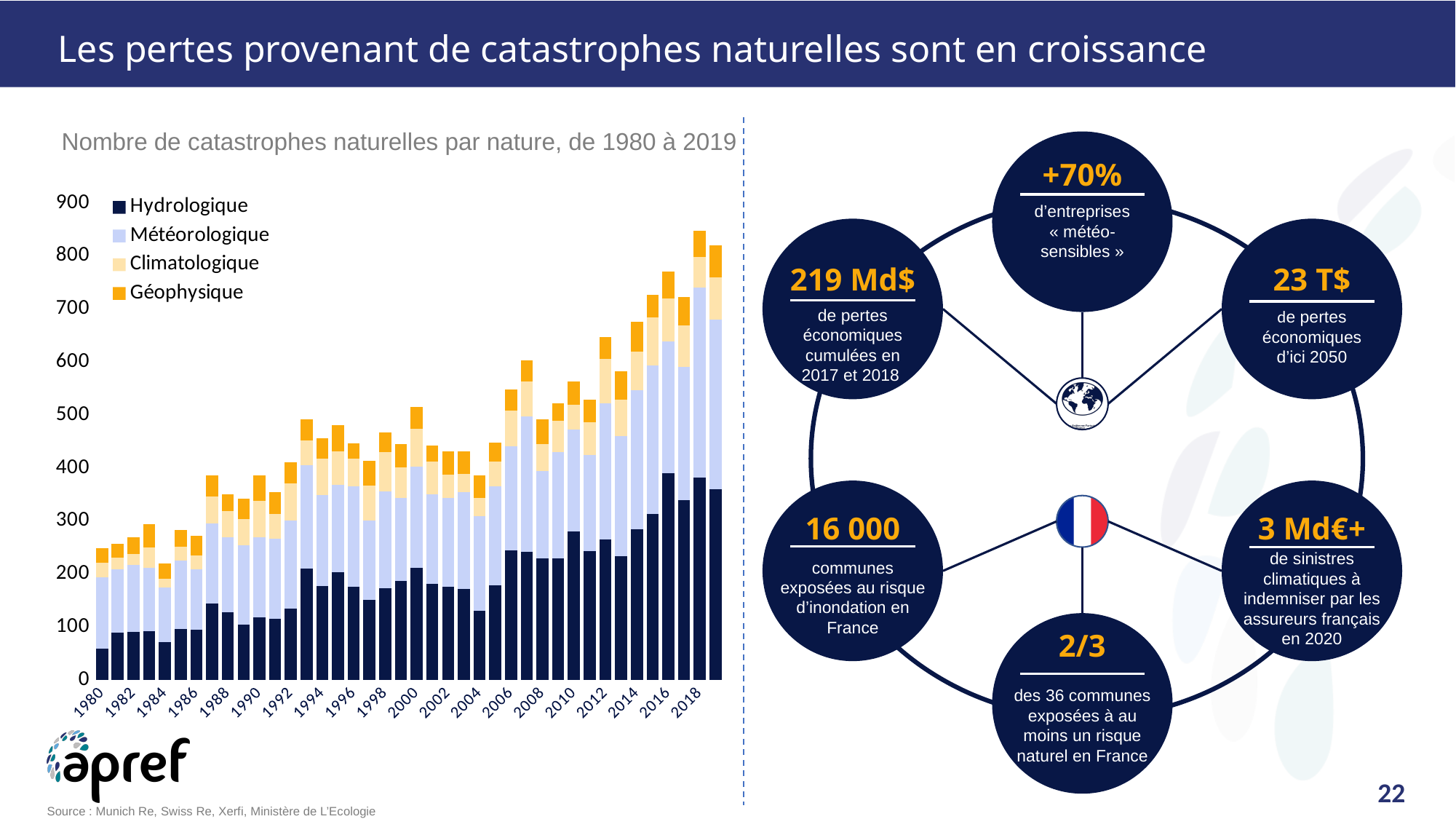
Which year has a larger total number of natural catastrophes, 2017 or 1990? 2017 How many years (bars) are plotted in the chart? 40 Which series are listed in the chart legend? Hydrologique, Météorologique, Climatologique, Géophysique How many series does the chart legend list? 4 Is the total for 1980 greater or less than 300? less Which year has the highest total number of natural catastrophes? 2018 What kind of chart is shown on the slide? Stacked bar chart Which year has the lowest total number of natural catastrophes? 1984 What is the title of the chart? Nombre de catastrophes naturelles par nature, de 1980 à 2019 Overall, do the total number of natural catastrophes rise or fall from 1980 to 2019? Rise Is the Hydrologique value for 2016 greater or less than 300? greater Is the total for 2017 greater or less than 800? less